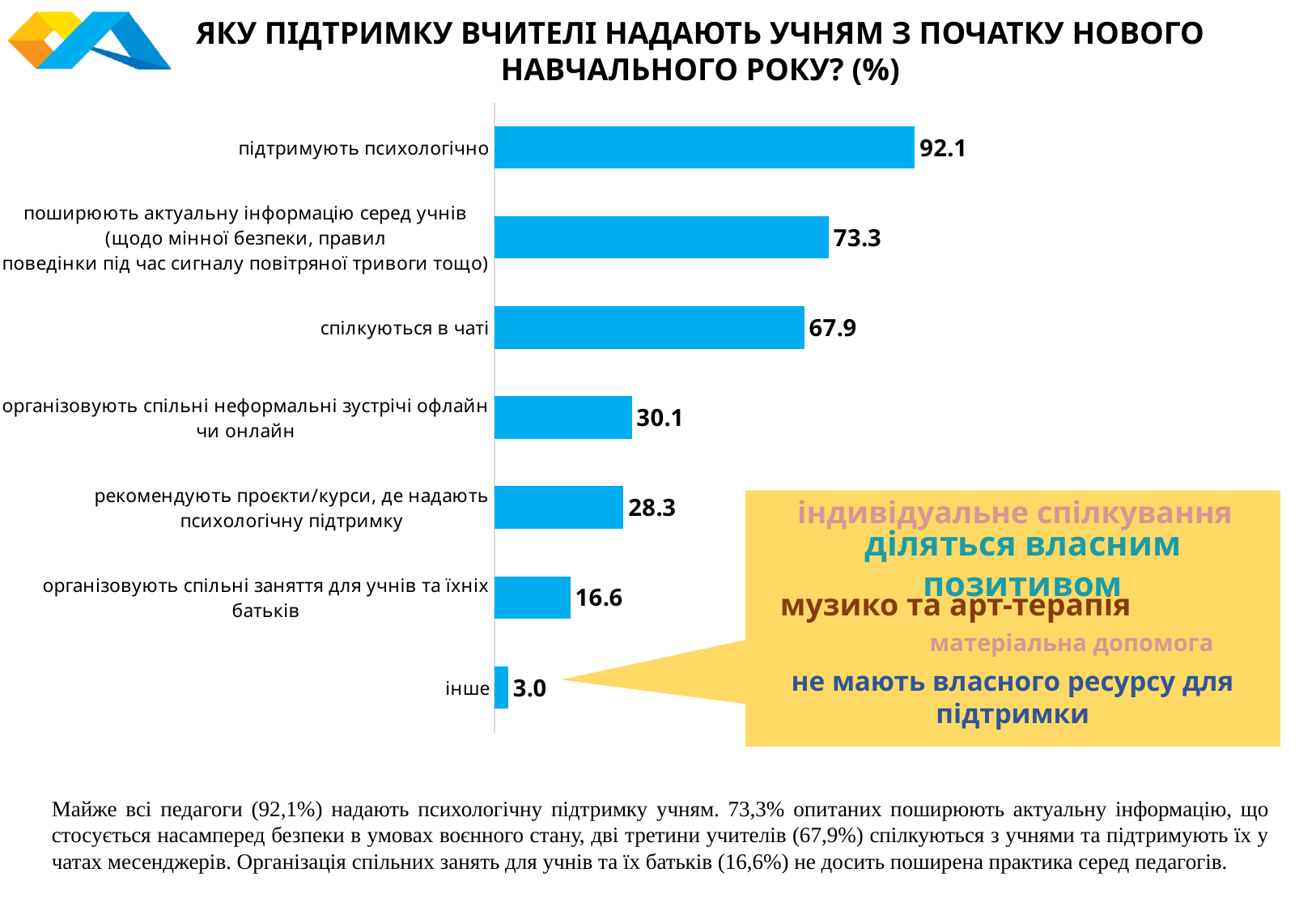
What is the difference between the values for "організовують спільні неформальні зустрічі офлайн чи онлайн" and "рекомендують проєкти/курси, де надають психологічну підтримку"? 1.8 What value is shown for "організовують спільні заняття для учнів та їхніх батьків"? 16.6 What is the difference between the values for "підтримують психологічно" and "поширюють актуальну інформацію серед учнів"? 18.8 Which category has the highest value? підтримують психологічно What value is shown for "інше"? 3.0 Which is larger: the value for "спілкуються в чаті" or the value for "організовують спільні неформальні зустрічі офлайн чи онлайн"? спілкуються в чаті What value is shown for "підтримують психологічно"? 92.1 What colour are the bars in the chart? blue What value is shown for "спілкуються в чаті"? 67.9 Which category has the lowest value? інше How many categories are shown in the chart? 7 What kind of chart is shown on the slide? bar chart